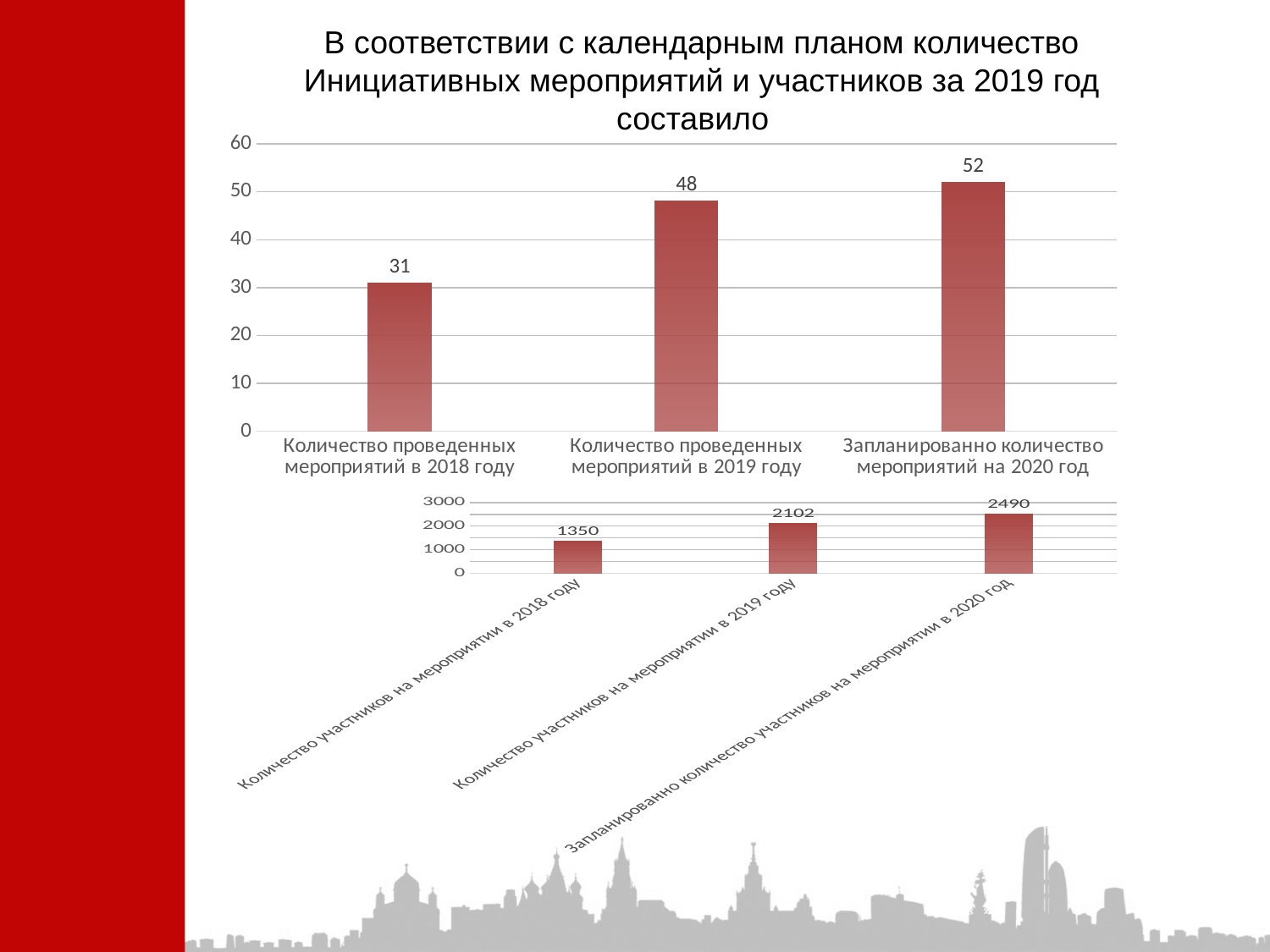
What type of chart is the bottom chart? bar chart In the top chart, what is the value for 'Количество проведенных мероприятий в 2019 году'? 48 In the bottom chart, which category has the highest value? Запланированно количество участников на мероприятии в 2020 год In the bottom chart, is the value for 'Количество участников на мероприятии в 2019 году' greater or less than 2000? greater In the bottom chart, what is the value for 'Количество участников на мероприятии в 2018 году'? 1350 In the top chart, what is the value for 'Запланированно количество мероприятий на 2020 год'? 52 In the top chart, how many bars are plotted? 3 In the bottom chart, what is the value for 'Запланированно количество участников на мероприятии в 2020 год'? 2490 In the top chart, what is the difference between the 2019 value and the 2018 value? 17 In the top chart, which category has the lowest value? Количество проведенных мероприятий в 2018 году In the bottom chart, what is the difference between the 2020 planned value and the 2019 value? 388 In the top chart, do the values rise or fall from left to right? rise